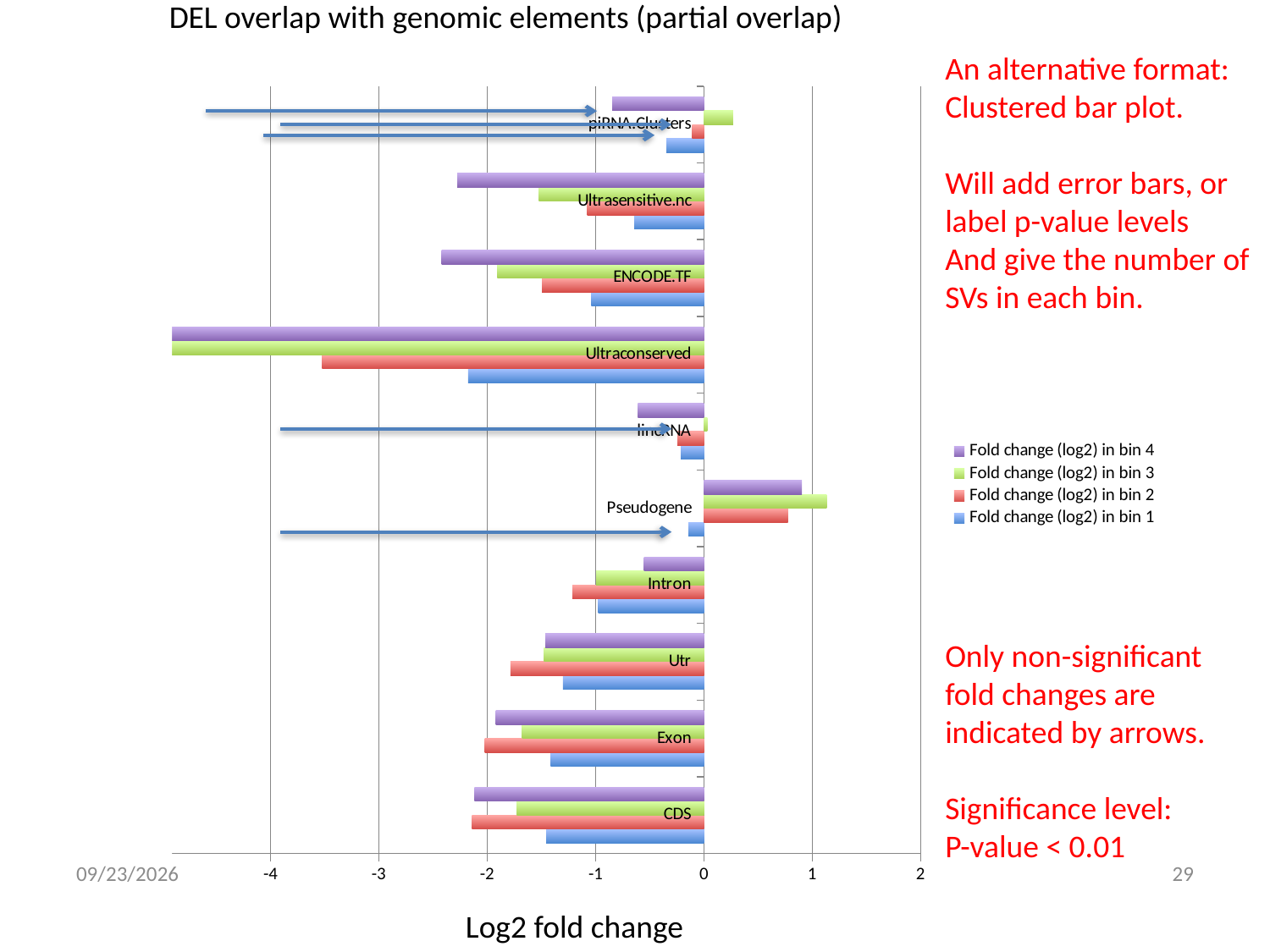
What is the label on the horizontal axis of the chart? Log2 fold change Which category has the lowest (most negative) value in bin 4? Ultraconserved What kind of chart is shown on the slide? bar chart Which category has the highest value in bin 3? Pseudogene Is the value for ENCODE.TF in bin 4 greater or less than -2? less How many categories (genomic elements) are plotted on the chart? 10 For Pseudogene, which is larger: the value in bin 3 or the value in bin 2? bin 3 What is the title of the chart? DEL overlap with genomic elements (partial overlap) Is the value for Pseudogene in bin 3 greater or less than 1? greater Is the value for Ultraconserved in bin 2 greater or less than -3? less How many series does the chart's legend list? 4